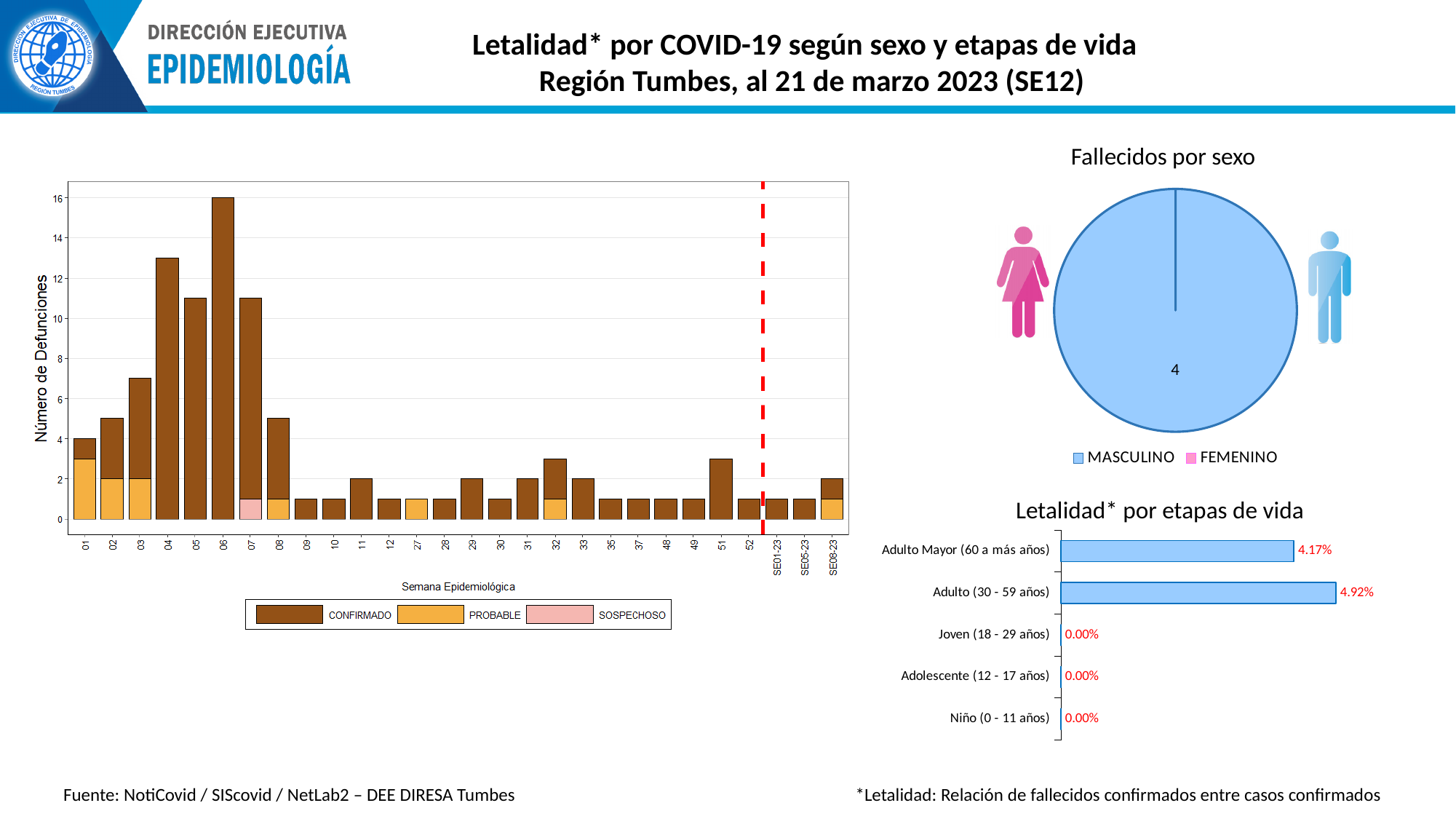
In the left chart of Número de Defunciones, how many series does the legend list? 3 In the left chart of Número de Defunciones, what is the total number of deaths in week 06? 16 In the 'Letalidad* por etapas de vida' chart, which age group has the highest lethality? Adulto (30 - 59 años) In the 'Letalidad* por etapas de vida' chart, how many age groups are shown? 5 In the 'Fallecidos por sexo' pie chart, what value is printed on the pie? 4 In the 'Letalidad* por etapas de vida' chart, what is the difference between the values for Adulto (30 - 59 años) and Adulto Mayor (60 a más años)? 0.75% What kind of chart is the chart on the left showing Número de Defunciones by Semana Epidemiológica? bar chart In the 'Letalidad* por etapas de vida' chart, what is the value for Adulto (30 - 59 años)? 4.92% In the left chart of Número de Defunciones, is the total for week 04 greater or less than 12? greater In the left chart of Número de Defunciones, is the total for week 08 greater or less than 6? less In the 'Fallecidos por sexo' pie chart, how many categories does the legend list? 2 In the left chart of Número de Defunciones, which epidemiological week has the highest number of deaths? 06